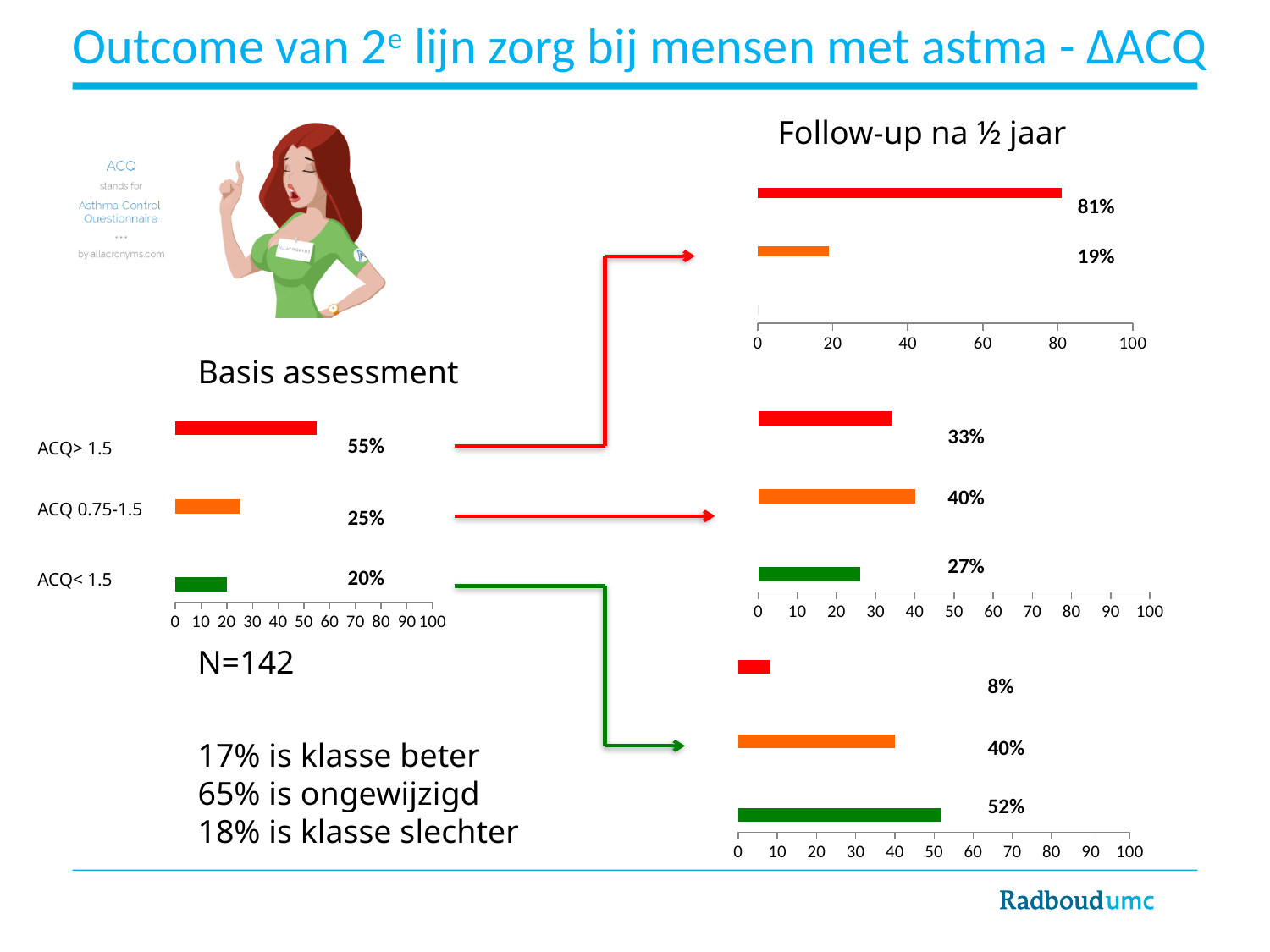
In the Basis assessment chart, which category has the lowest value? ACQ< 1.5 In the Basis assessment chart, what is the value for ACQ< 1.5? 20% In the Basis assessment chart, what is the value for ACQ 0.75-1.5? 25% In the bottom-right follow-up chart, what is the difference between the green bar and the red bar? 44% In the top-right follow-up chart, what is the value of the red bar? 81% In the Basis assessment chart, what is the value for ACQ> 1.5? 55% In the middle-right follow-up chart, which is larger, the red bar or the green bar? the red bar In the Basis assessment chart, which category has the highest value? ACQ> 1.5 In the middle-right follow-up chart, what is the value of the orange bar? 40% What kind of chart is the Basis assessment chart? bar chart How many categories are shown in the Basis assessment chart? 3 In the Basis assessment chart, what is the difference between the values for ACQ> 1.5 and ACQ 0.75-1.5? 30%